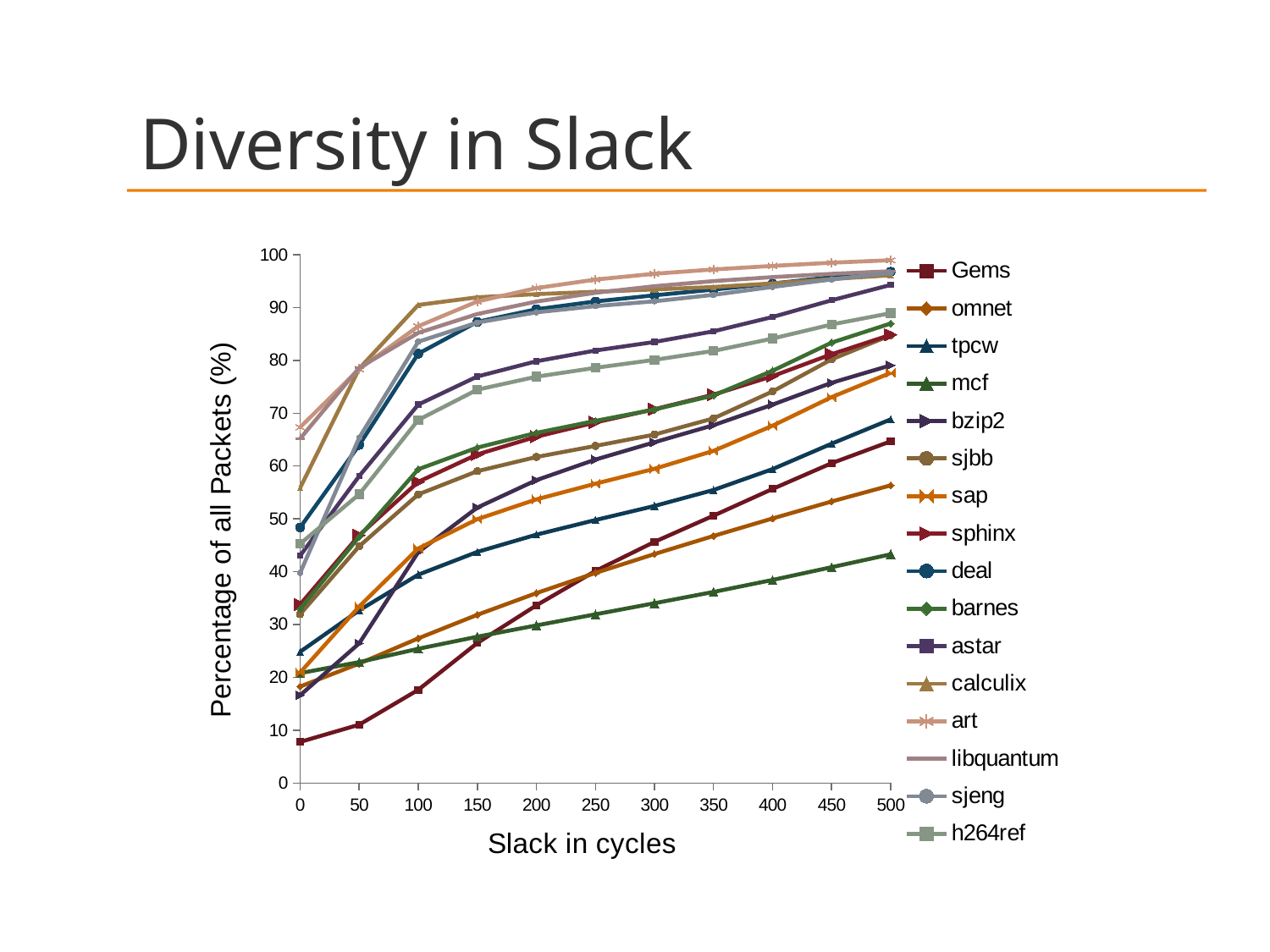
What kind of chart is shown on the slide? line chart How many slack values (x-axis points) are plotted for each series? 11 Which series has the lowest percentage of packets at a slack of 0 cycles? Gems At a slack of 500 cycles, which is larger: the value for Gems or the value for mcf? Gems Is the value for art at a slack of 500 cycles greater or less than 90? greater Which series has the highest percentage of packets at a slack of 500 cycles? art What is the label of the y axis? Percentage of all Packets (%) How many series does the legend list? 16 Is the value for Gems at a slack of 0 cycles greater or less than 10? less Which series has the lowest percentage of packets at a slack of 500 cycles? mcf Is the value for mcf at a slack of 500 cycles greater or less than 50? less Do the values for Gems rise or fall as slack increases along the x axis? rise